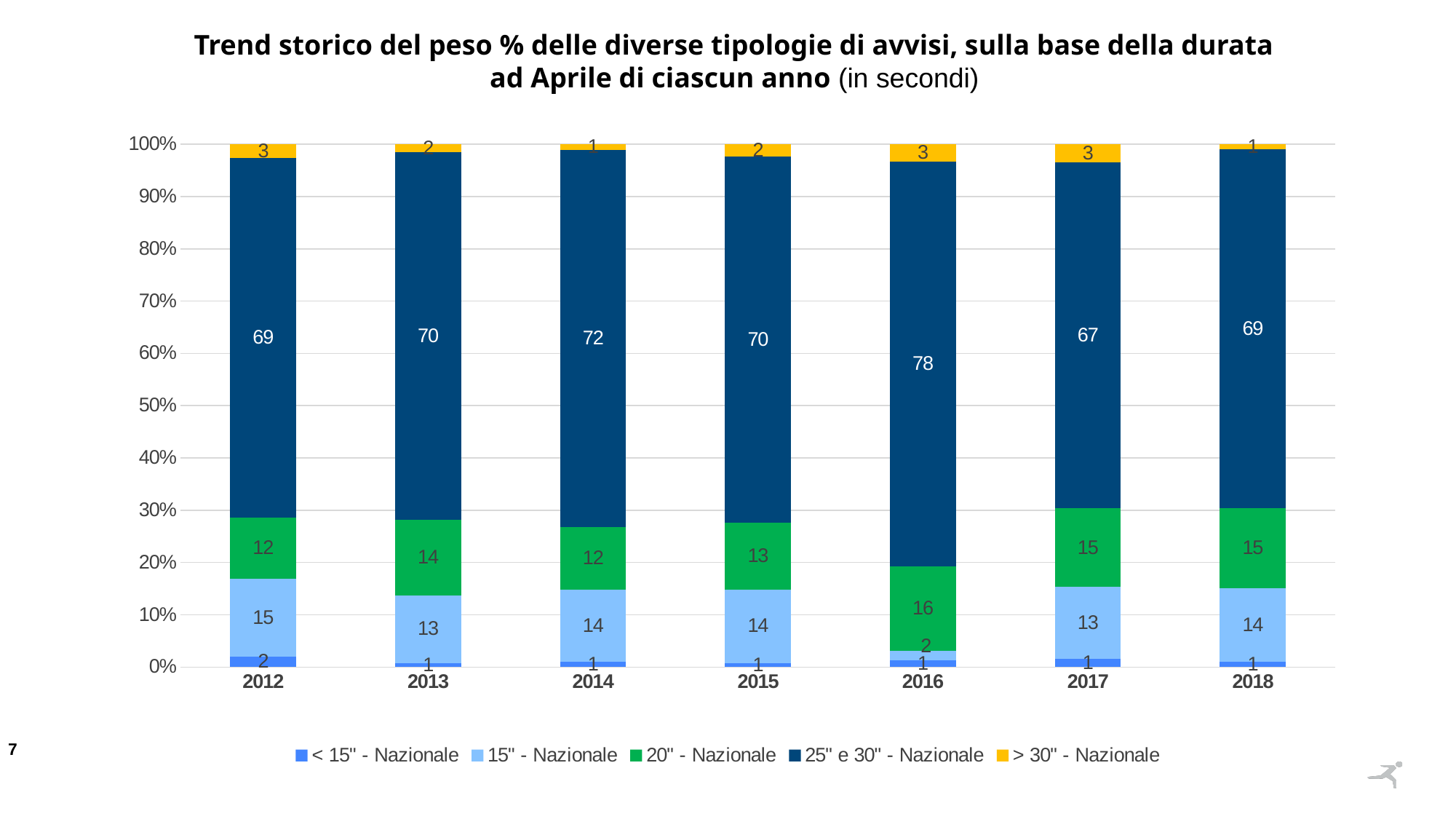
In which year is the 25'' e 30'' - Nazionale series lowest? 2017 What is the value for the 15'' - Nazionale series in 2012? 15 Which is larger, the 20'' - Nazionale value in 2016 or in 2014? 2016 What is the difference between the 25'' e 30'' - Nazionale values for 2016 and 2017? 11 What kind of chart is shown on the slide? Stacked bar chart What is the value for the 25'' e 30'' - Nazionale series in 2016? 78 What is the value for the > 30'' - Nazionale series in 2017? 3 Which colour represents the > 30'' - Nazionale series? Yellow In which year is the 25'' e 30'' - Nazionale series highest? 2016 How many series does the legend list? 5 How many years are shown on the x axis? 7 What is the value for the 20'' - Nazionale series in 2013? 14